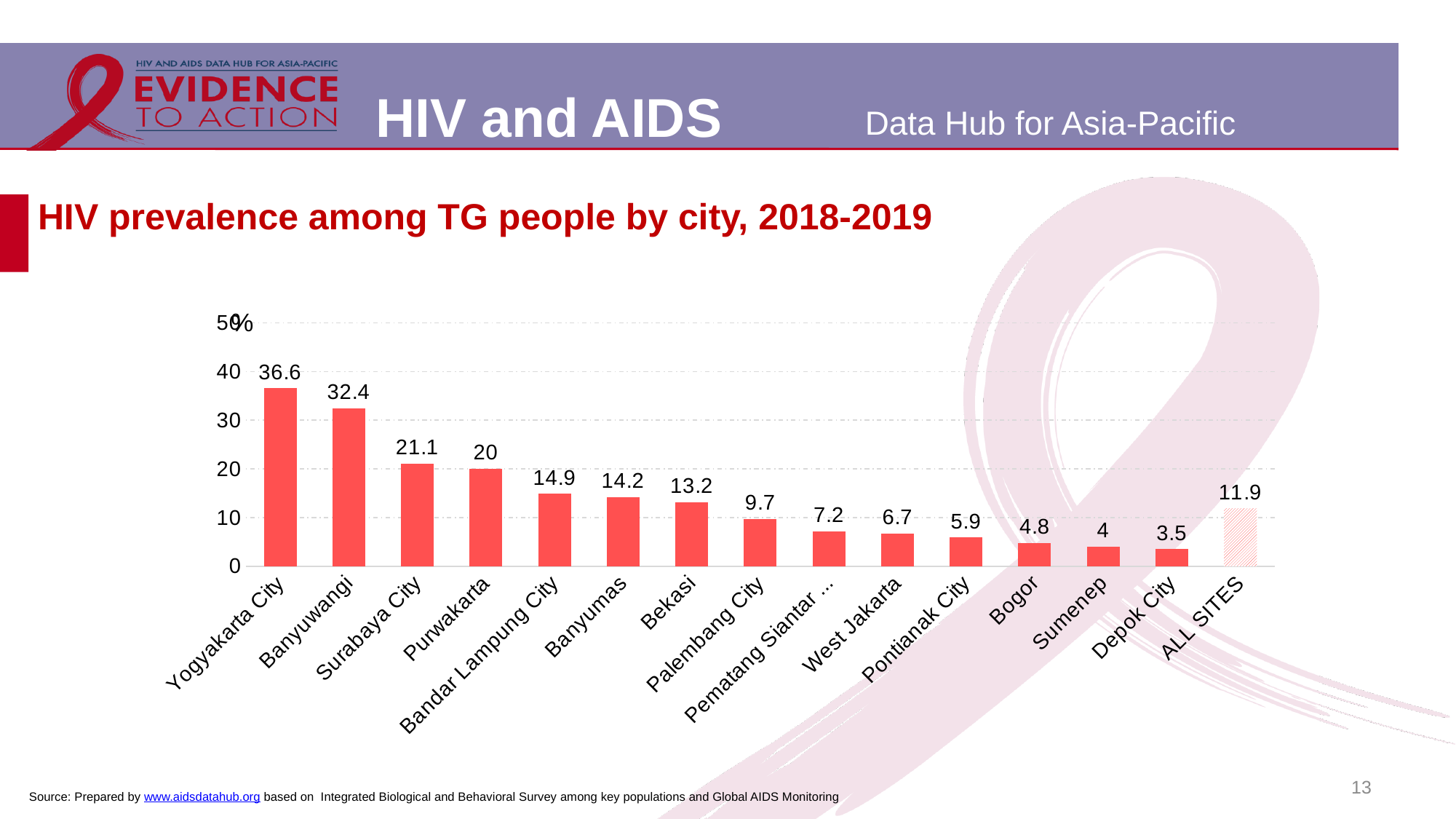
What is the HIV prevalence value shown for Yogyakarta City? 36.6 What is the title of the chart on the slide? HIV prevalence among TG people by city, 2018-2019 Which city has the lowest HIV prevalence in the chart? Depok City What is the difference between the values for Yogyakarta City and Banyuwangi? 4.2 What is the value shown for Bekasi? 13.2 What is the difference between the values for Surabaya City and Purwakarta? 1.1 Which city has the highest HIV prevalence in the chart? Yogyakarta City How many bars are plotted in the chart? 15 What type of chart is shown on the slide? Bar chart Which has a higher value, Bandar Lampung City or Palembang City? Bandar Lampung City What is the value shown for ALL SITES? 11.9 Is the value for Banyuwangi greater or less than 30? greater